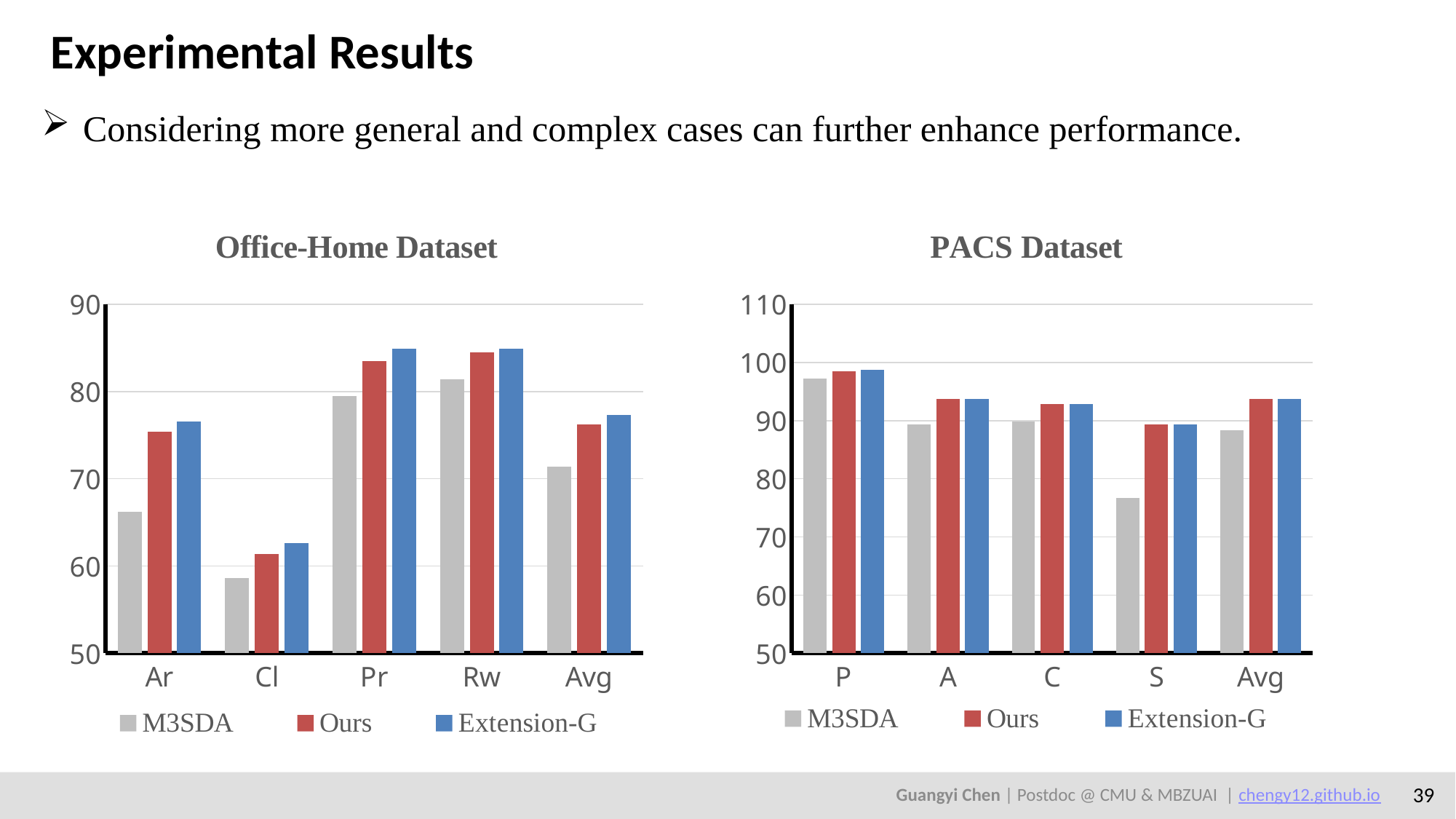
In the PACS Dataset chart, which category has the lowest M3SDA value? S In the Office-Home Dataset chart, which category has the lowest M3SDA value? Cl In the PACS Dataset chart, is the Ours value for Avg greater or less than 90? greater What type of chart is the Office-Home Dataset chart? bar chart How many series does the legend of the Office-Home Dataset chart list? 3 What are the three legend entries of the PACS Dataset chart? M3SDA, Ours, Extension-G In the PACS Dataset chart, which category has the highest M3SDA value? P In the Office-Home Dataset chart, is the Extension-G value for Pr greater or less than 80? greater How many categories are shown on the x axis of the PACS Dataset chart? 5 In the PACS Dataset chart, is the M3SDA value for S greater or less than 80? less In the Office-Home Dataset chart, which is larger for Cl: the M3SDA value or the Ours value? Ours